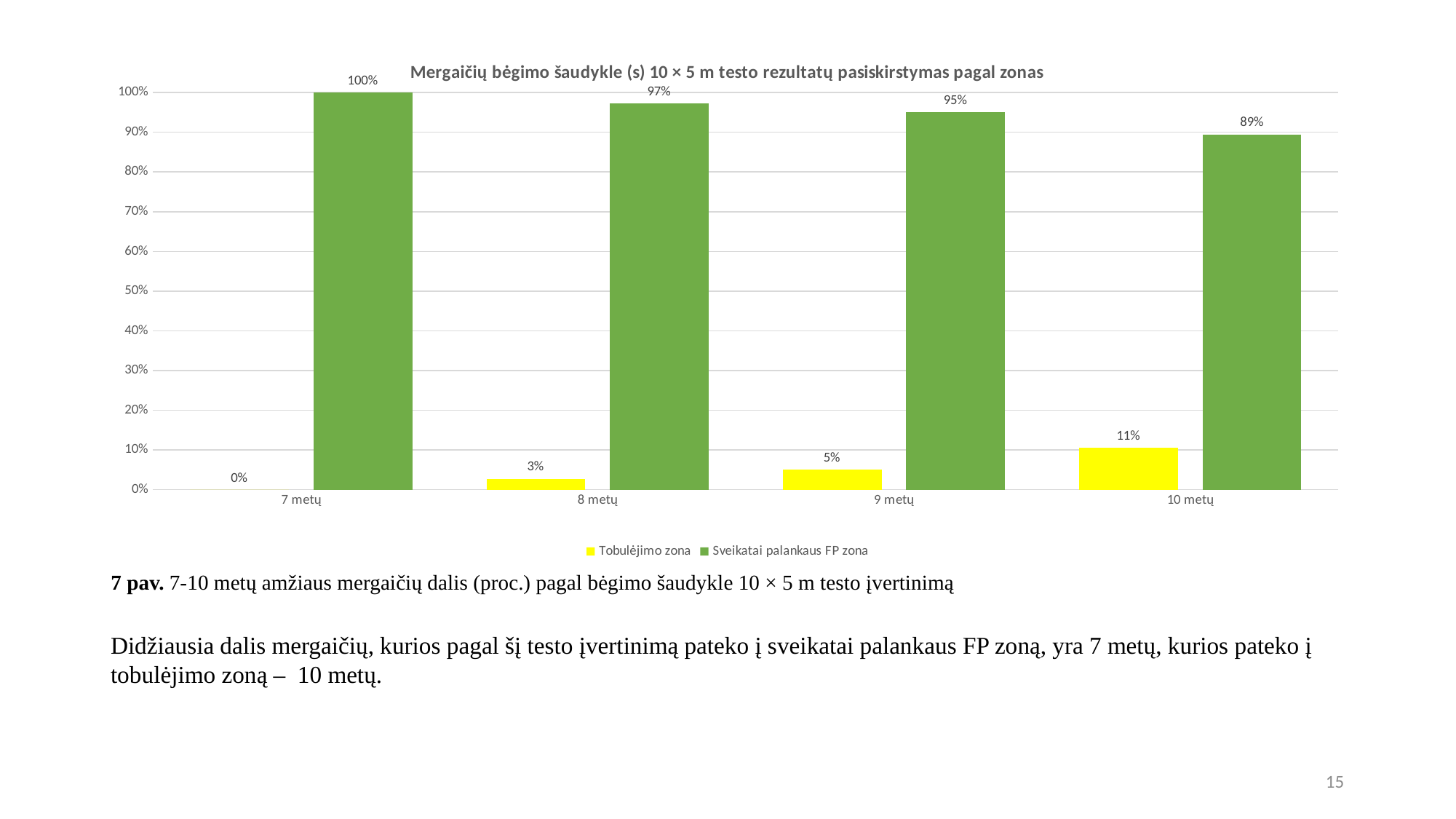
What is the value for Tobulėjimo zona at 9 metų? 5% Do the Sveikatai palankaus FP zona values rise or fall from 7 metų to 10 metų? Fall What kind of chart is shown on the slide? Bar chart Which age group has the lowest value for Sveikatai palankaus FP zona? 10 metų How many age groups are shown on the x axis? 4 How many series does the legend list? 2 What is the value for Tobulėjimo zona at 10 metų? 11% What is the difference between the Sveikatai palankaus FP zona values for 7 metų and 10 metų? 11% What is the value for Sveikatai palankaus FP zona at 8 metų? 97% Which age group has the highest value for Tobulėjimo zona? 10 metų Which is larger: the Tobulėjimo zona value for 8 metų or for 9 metų? 9 metų What is the value for Sveikatai palankaus FP zona at 7 metų? 100%